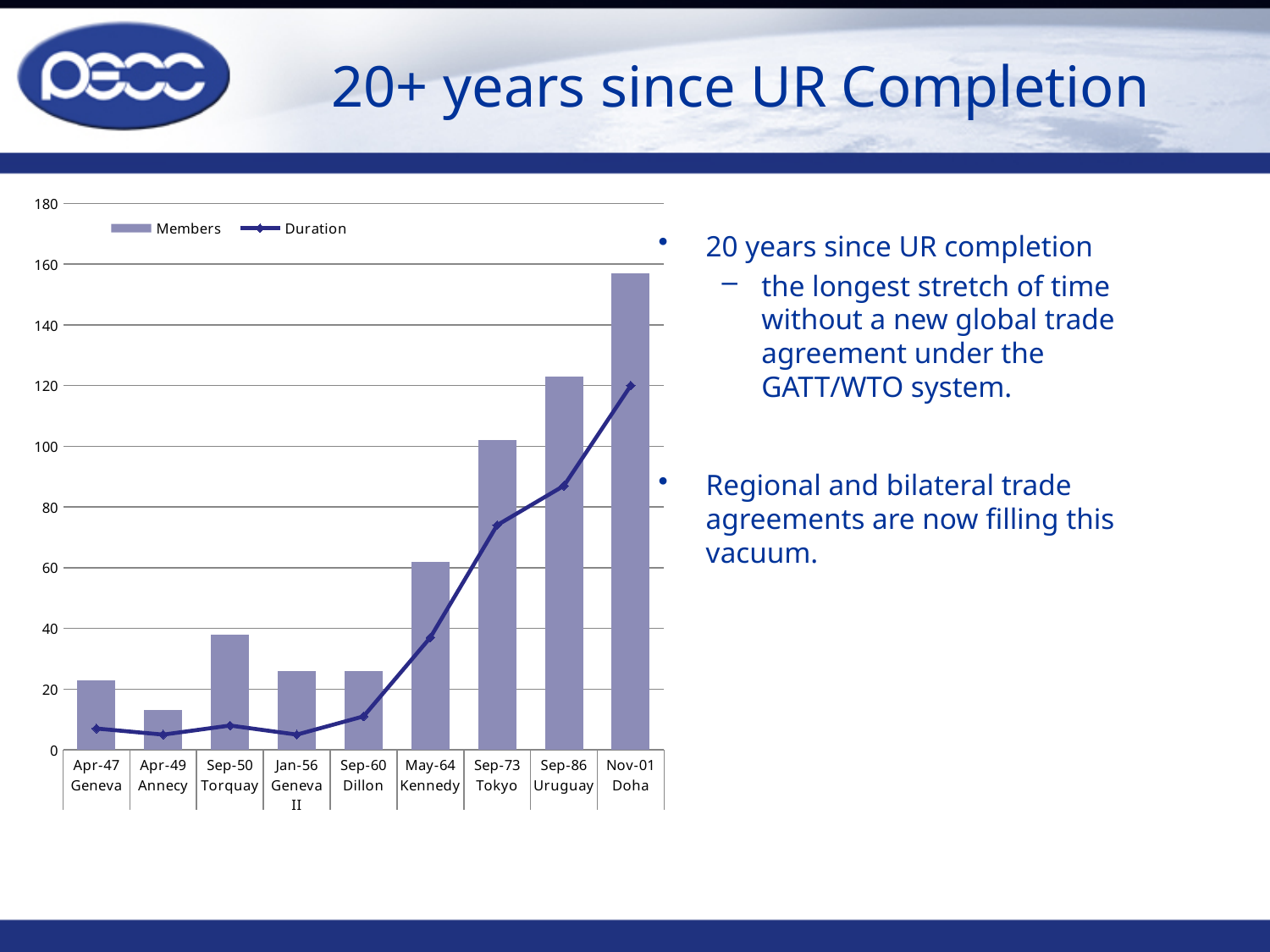
Does the Duration line rise or fall from Sep-60 Dillon to Nov-01 Doha? rise Which round has the highest Members value? Nov-01 Doha What kind of chart is shown on the slide? Combined bar and line chart Which round has the highest Duration value? Nov-01 Doha How many trade rounds (categories) are shown on the x axis of the chart? 9 Is the Members value for Nov-01 Doha greater or less than 140? greater Which series is drawn as a line in the chart? Duration How many series does the chart legend list? 2 Which round has the lowest Members value? Apr-49 Annecy Which has the larger Members value, Sep-73 Tokyo or Sep-86 Uruguay? Sep-86 Uruguay Is the Duration value for Nov-01 Doha greater or less than 100? greater Is the Duration value for May-64 Kennedy greater or less than 60? less